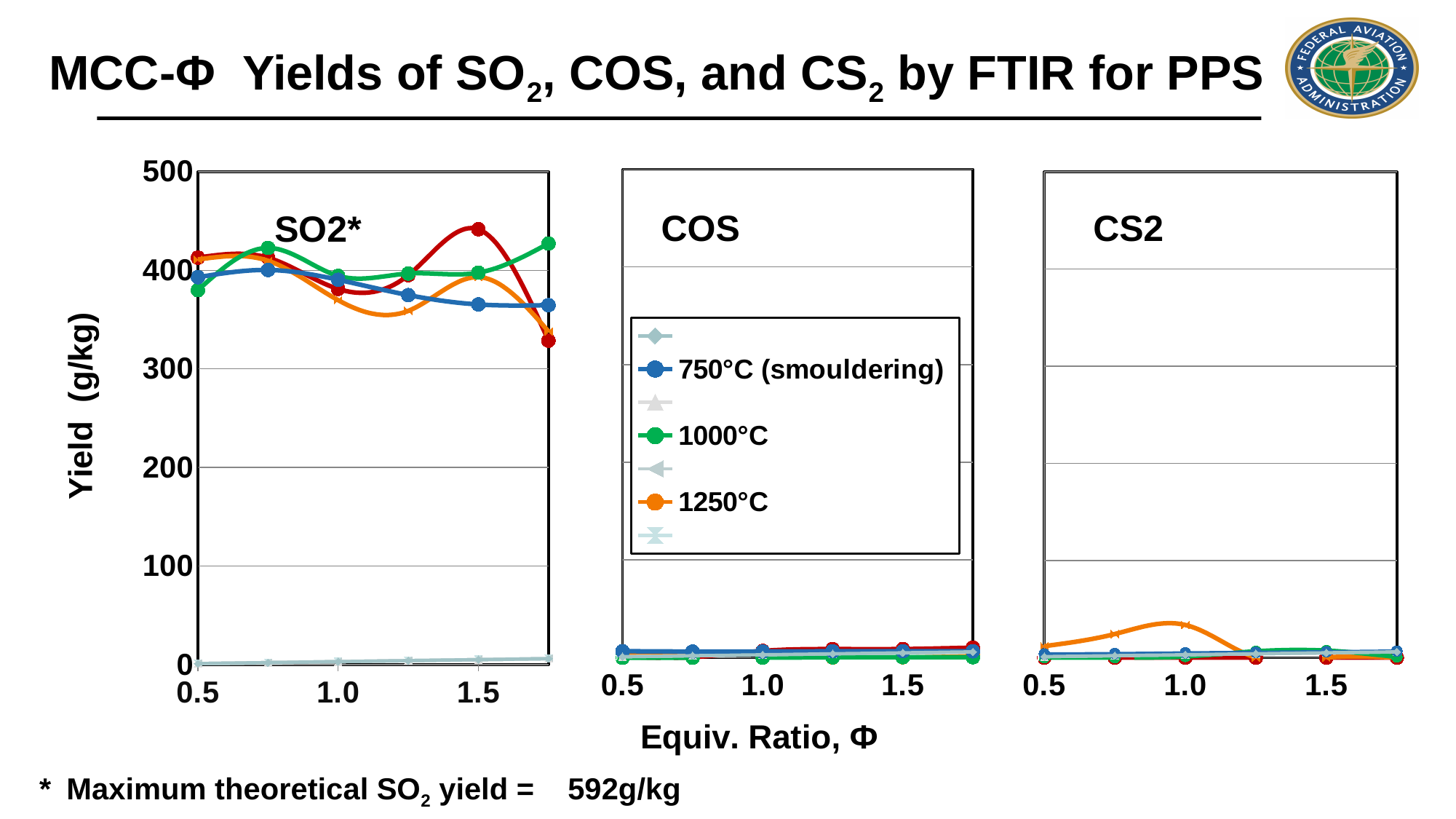
In the SO2* chart, which is larger at equivalence ratio 1.75: the value for 1000°C or the value for 750°C (smouldering)? 1000°C In the SO2* chart, is the value for 1000°C at equivalence ratio 1.75 greater or less than 400? greater In the SO2* chart, which labelled series has the highest value at equivalence ratio 1.75? 1000°C How many temperature conditions are labelled in the legend? 3 What kind of chart is the SO2* chart on the left? line chart What is the label of the shared y axis? Yield (g/kg) In the SO2* chart, does the 750°C (smouldering) series generally rise or fall from equivalence ratio 0.75 to 1.75? fall According to the footnote, what is the maximum theoretical SO2 yield? 592g/kg How many charts are shown on the slide? 3 In the COS chart, is the value for 1000°C at equivalence ratio 1.0 greater or less than 100? less In the SO2* chart, is the value for 750°C (smouldering) at equivalence ratio 0.5 greater or less than 300? greater